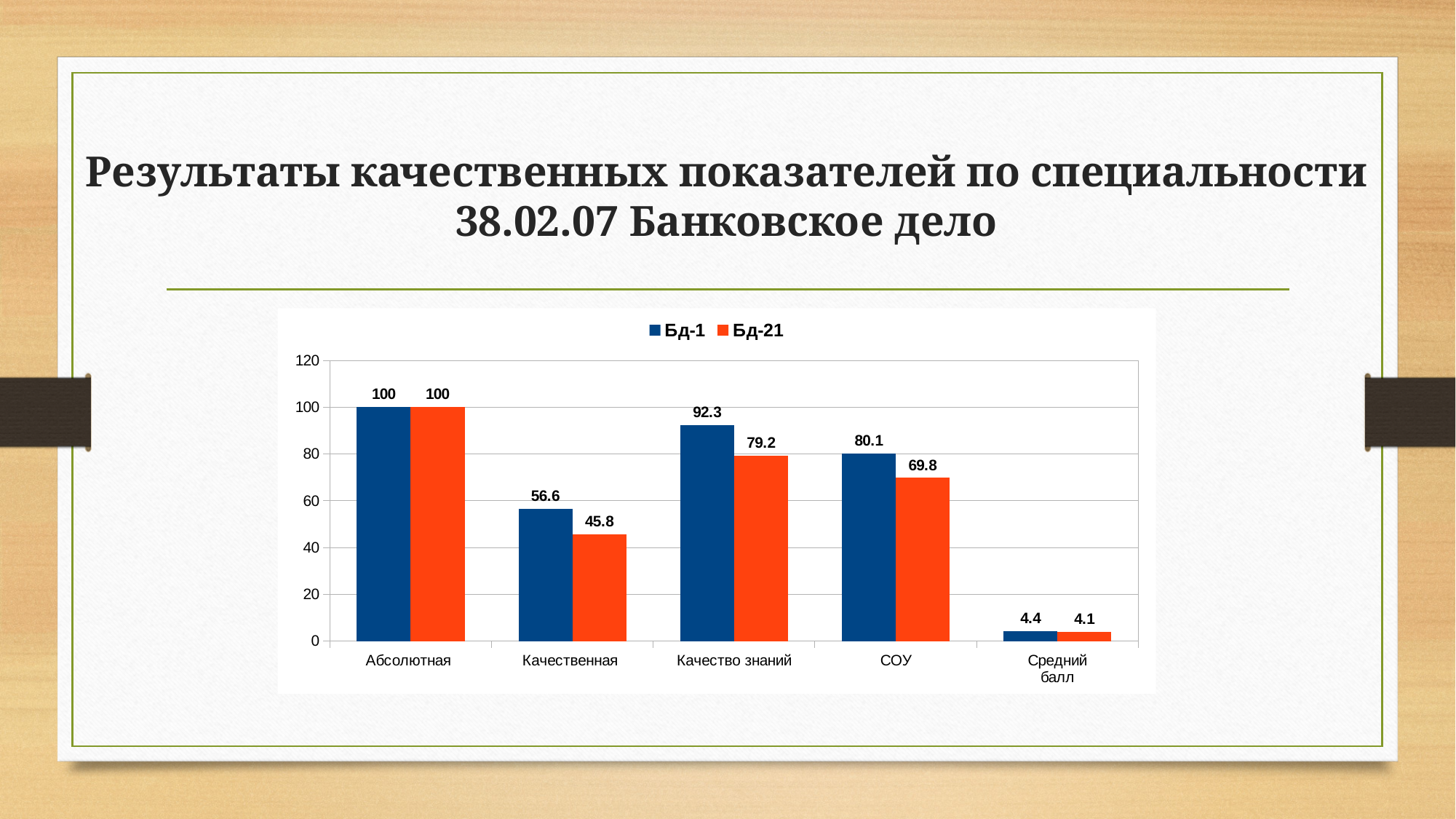
Which series has the larger value in the СОУ category, Бд-1 or Бд-21? Бд-1 What is the difference between the Бд-1 and Бд-21 values in the Качественная category? 10.8 What kind of chart is shown on the slide? Bar chart Which category has the highest value for the Бд-1 series? Абсолютная Which category has the lowest value for the Бд-21 series? Средний балл What is the value for Бд-21 in the Качество знаний category? 79.2 What is the value for Бд-21 in the СОУ category? 69.8 How many categories are shown on the x axis? 5 What is the value for Бд-1 in the Средний балл category? 4.4 What is the difference between the Бд-1 and Бд-21 values in the Качество знаний category? 13.1 How many series does the legend list? 2 What is the value for Бд-1 in the Качественная category? 56.6